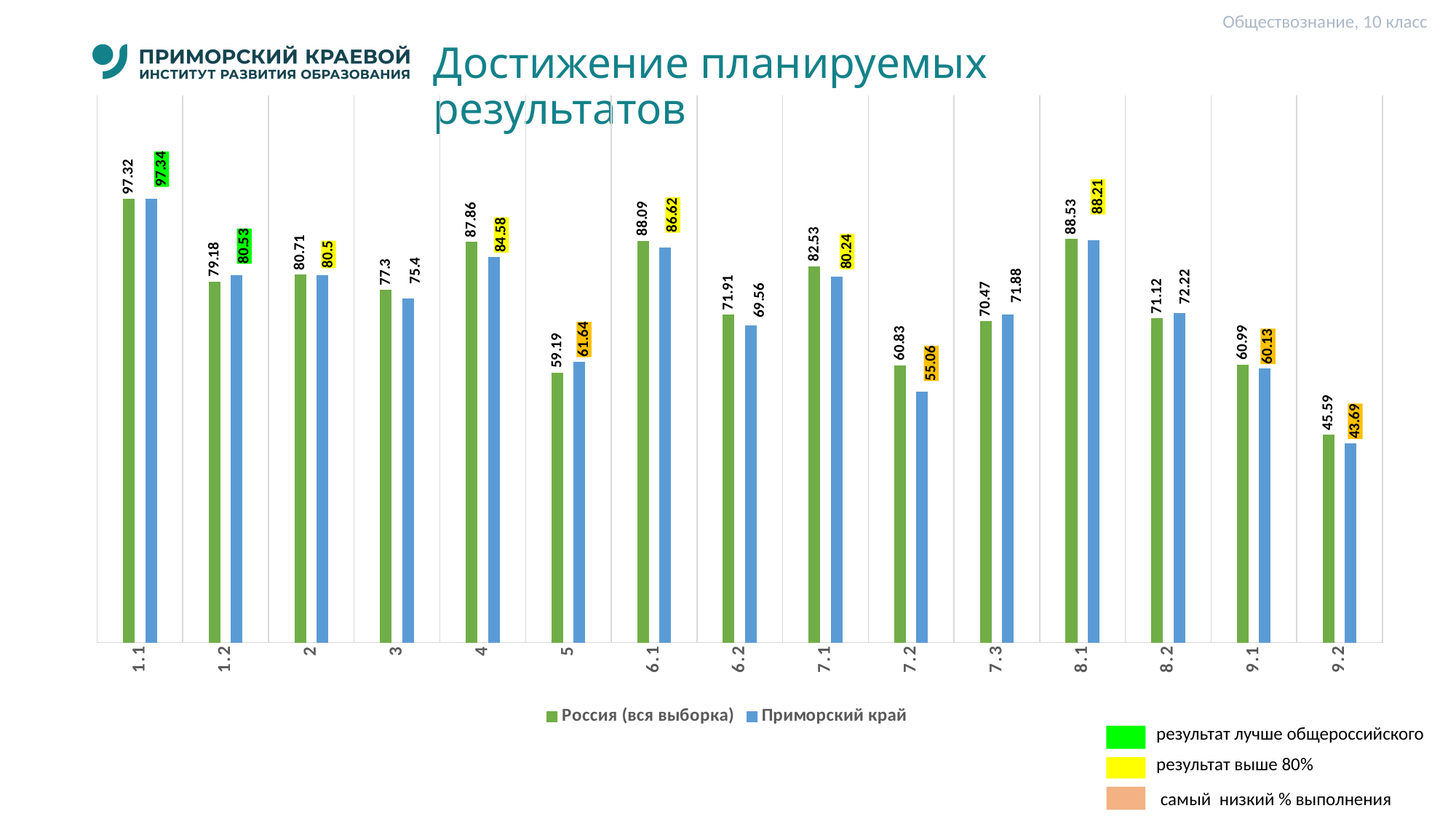
For category 5, which series has the larger value: Россия (вся выборка) or Приморский край? Приморский край Which category has the highest value for Приморский край? 1.1 What is the value for Приморский край for category 7.2? 55.06 What is the value for Приморский край for category 1.2? 80.53 How many categories are shown on the x axis? 15 Which category has the lowest value for Россия (вся выборка)? 9.2 What is the value for Россия (вся выборка) for category 4? 87.86 What is the difference between the Приморский край values for categories 1.1 and 9.2? 53.65 Which series is shown in green in the chart legend? Россия (вся выборка) What kind of chart is shown on the slide? bar chart How many series does the chart legend list? 2 What is the difference between the Россия (вся выборка) and Приморский край values for category 7.2? 5.77